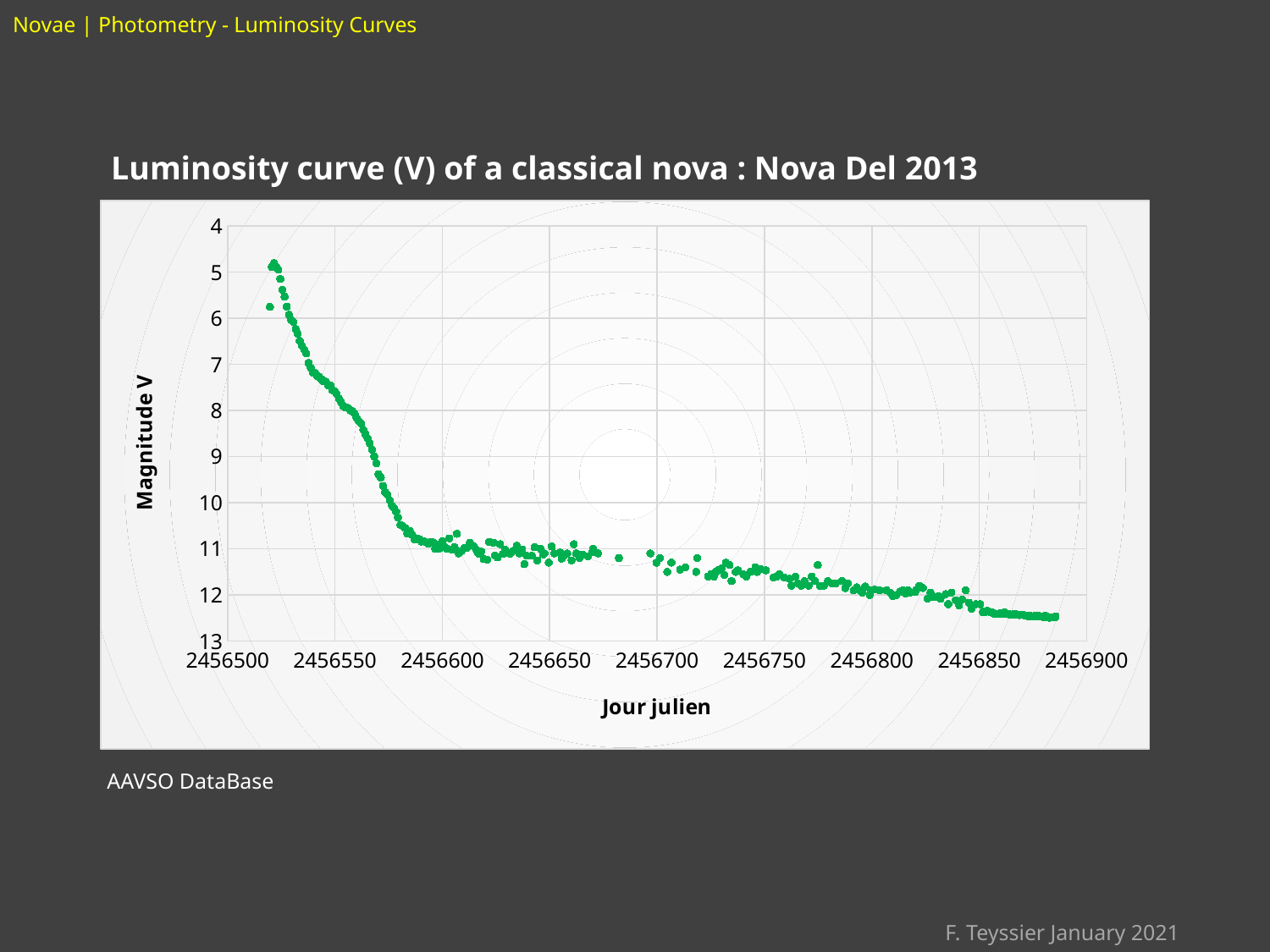
Do the smallest magnitude values occur at the left end or the right end of the x axis? Left end Is the magnitude value of the earliest points, near Julian day 2456520, greater or less than 6? less Is the magnitude value of the points near Julian day 2456700 greater or less than 10? greater Do the plotted magnitude values increase or decrease as the Julian day increases along the x axis? Increase Is the magnitude value of the points near Julian day 2456880 greater or less than 12? greater How many tick labels are shown on the x axis? 9 What is the title of the chart? Luminosity curve (V) of a classical nova : Nova Del 2013 What is the label of the y axis? Magnitude V What are the lowest and highest values labelled on the y axis? 4 and 13 Do the largest magnitude values occur at the left end or the right end of the x axis? Right end What kind of chart is shown on the slide? Scatter chart